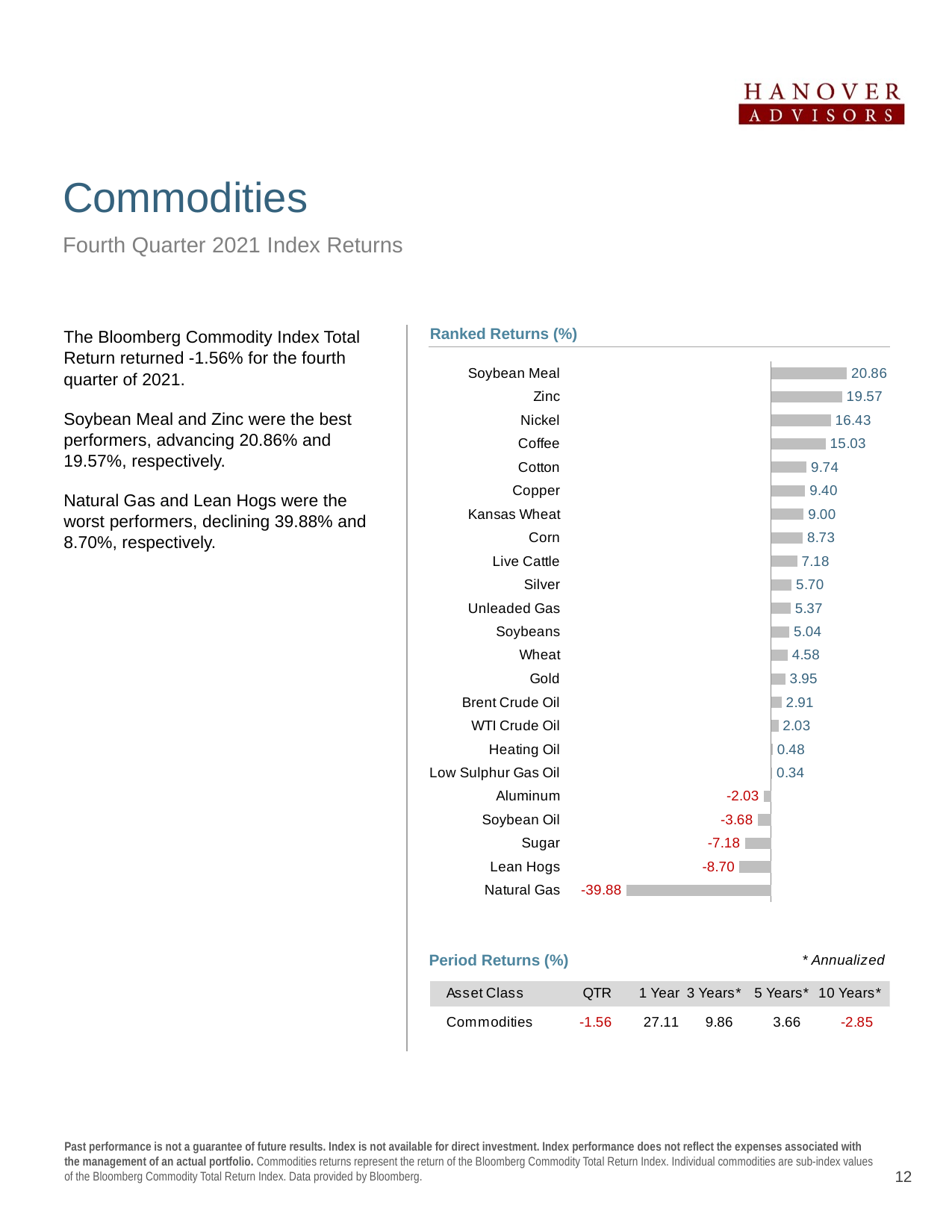
Which has the larger ranked return, Sugar or Soybean Oil? Soybean Oil What kind of chart is the Ranked Returns chart? Bar chart Which commodity has the lowest ranked return? Natural Gas What is the difference between the ranked returns of Coffee and Cotton? 5.29 Which has the larger ranked return, Copper or Corn? Copper How many commodities are shown in the Ranked Returns chart? 23 What is the ranked return for Nickel? 16.43 What is the ranked return for Lean Hogs? -8.70 Which commodity has the highest ranked return? Soybean Meal How many commodities in the Ranked Returns chart have negative returns? 5 What is the ranked return for Low Sulphur Gas Oil? 0.34 What is the difference between the ranked returns of Soybean Meal and Zinc? 1.29